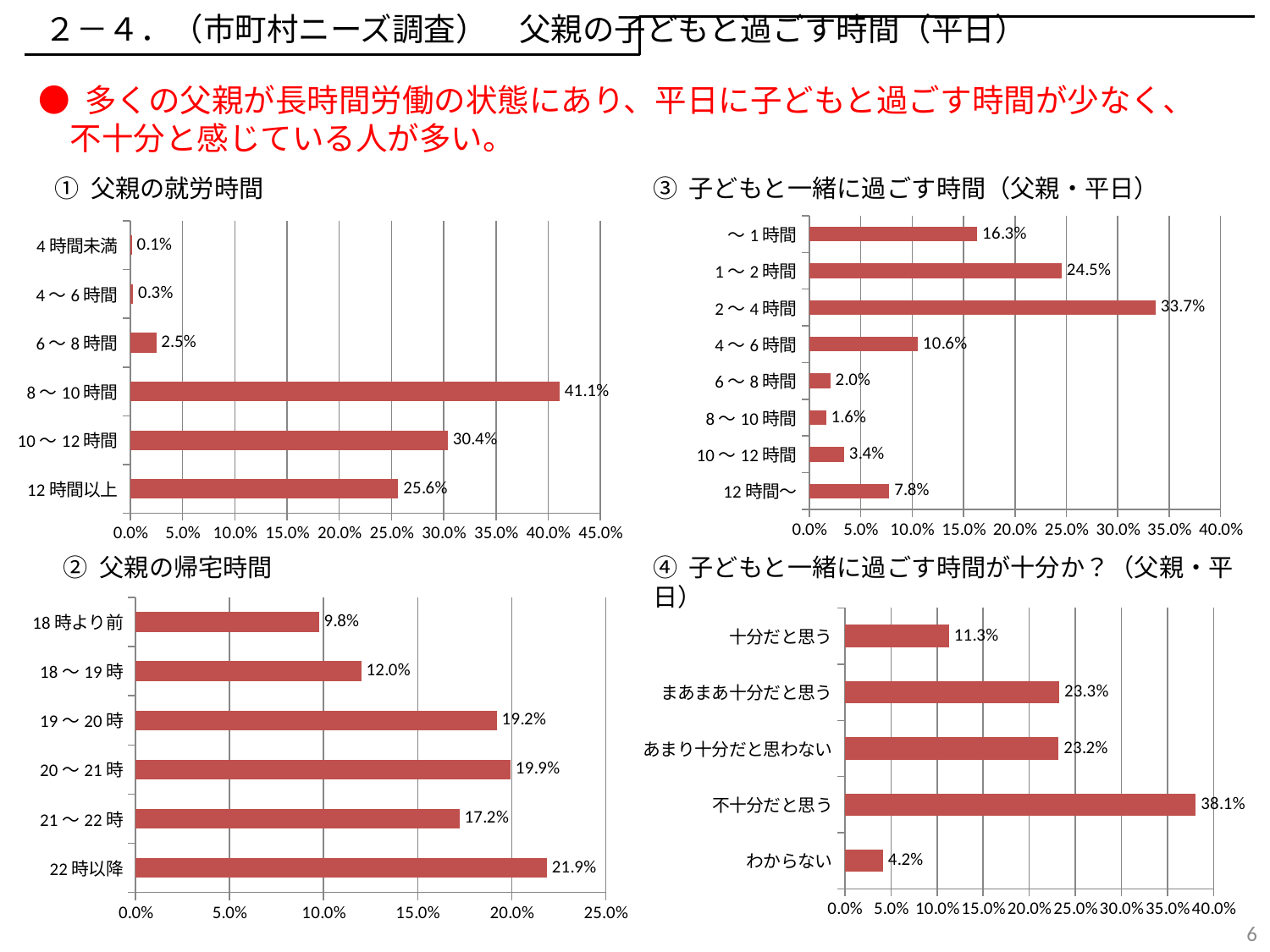
In the chart ③ 子どもと一緒に過ごす時間（父親・平日）, what is the value for 2～4時間? 33.7% In the chart ① 父親の就労時間, what is the difference between 10～12時間 and 12時間以上? 4.8% In the chart ④ 子どもと一緒に過ごす時間が十分か？, what is the value for わからない? 4.2% In the chart ② 父親の帰宅時間, how many categories are shown? 6 In the chart ④ 子どもと一緒に過ごす時間が十分か？, which is larger: 十分だと思う or 不十分だと思う? 不十分だと思う In the chart ② 父親の帰宅時間, which category has the highest value? 22時以降 In the chart ① 父親の就労時間, what is the value for 8～10時間? 41.1% In the chart ③ 子どもと一緒に過ごす時間（父親・平日）, which category has the lowest value? 8～10時間 In the chart ① 父親の就労時間, which category has the lowest value? 4時間未満 In the chart ③ 子どもと一緒に過ごす時間（父親・平日）, how many categories are shown? 8 What type of chart is ④ 子どもと一緒に過ごす時間が十分か？? bar chart In the chart ② 父親の帰宅時間, what is the value for 19～20時? 19.2%